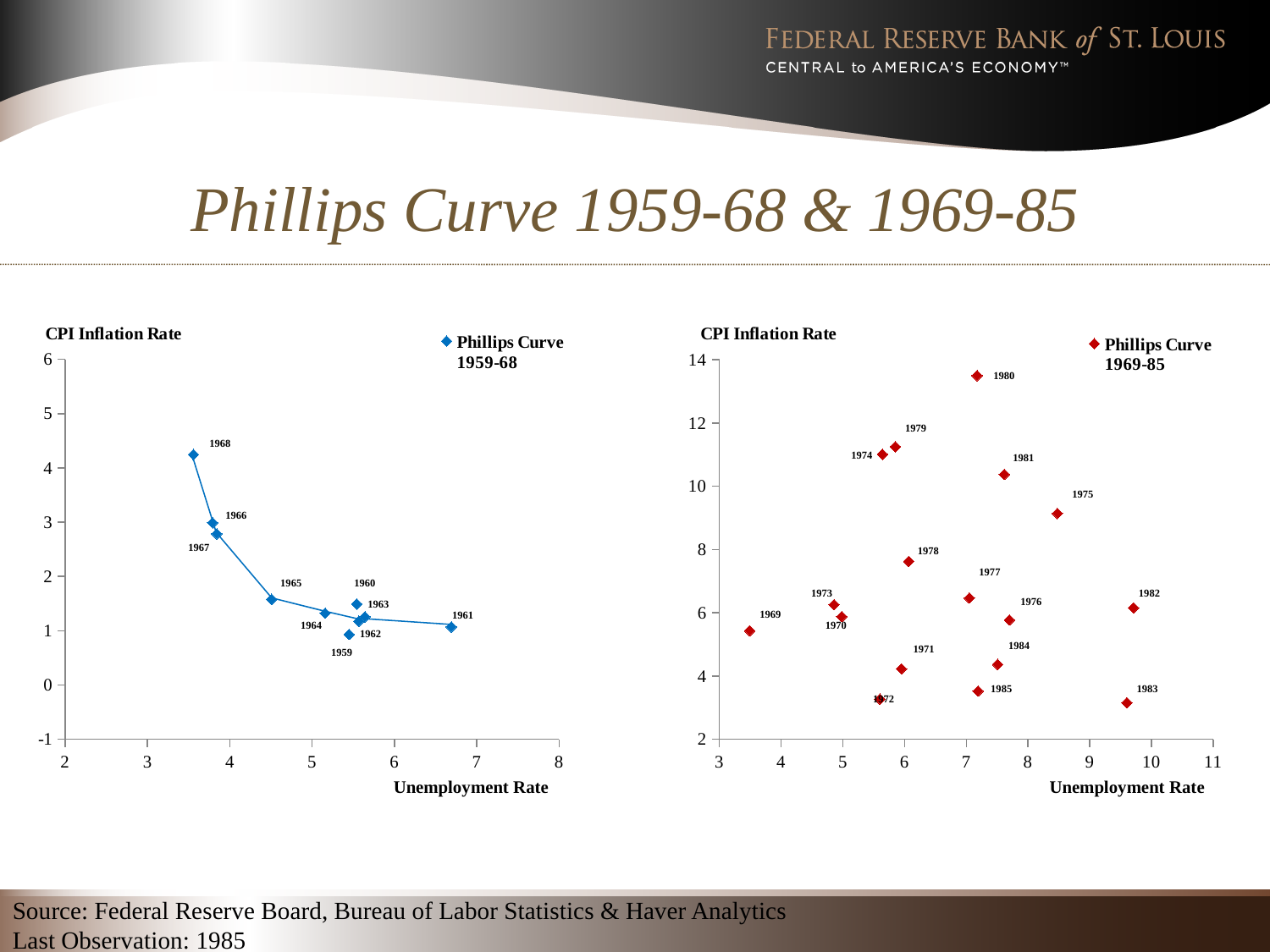
On the left chart, Phillips Curve 1959-68, which year has the highest CPI inflation rate? 1968 On the left chart, Phillips Curve 1959-68, is the CPI inflation rate for 1968 greater or less than 4? greater How many series does the legend of the right chart, Phillips Curve 1969-85, list? 1 On the right chart, Phillips Curve 1969-85, is the CPI inflation rate for 1980 greater or less than 12? greater What is the label on the horizontal axis of the left chart, Phillips Curve 1959-68? Unemployment Rate On the right chart, Phillips Curve 1969-85, which year has the higher CPI inflation rate, 1978 or 1979? 1979 How many data points are plotted on the right chart, Phillips Curve 1969-85? 17 What kind of chart is the left chart, Phillips Curve 1959-68? scatter chart On the left chart, Phillips Curve 1959-68, which year has the lowest CPI inflation rate? 1959 How many data points are plotted on the left chart, Phillips Curve 1959-68? 10 On the right chart, Phillips Curve 1969-85, which year has the lowest unemployment rate? 1969 On the right chart, Phillips Curve 1969-85, which year has the highest CPI inflation rate? 1980